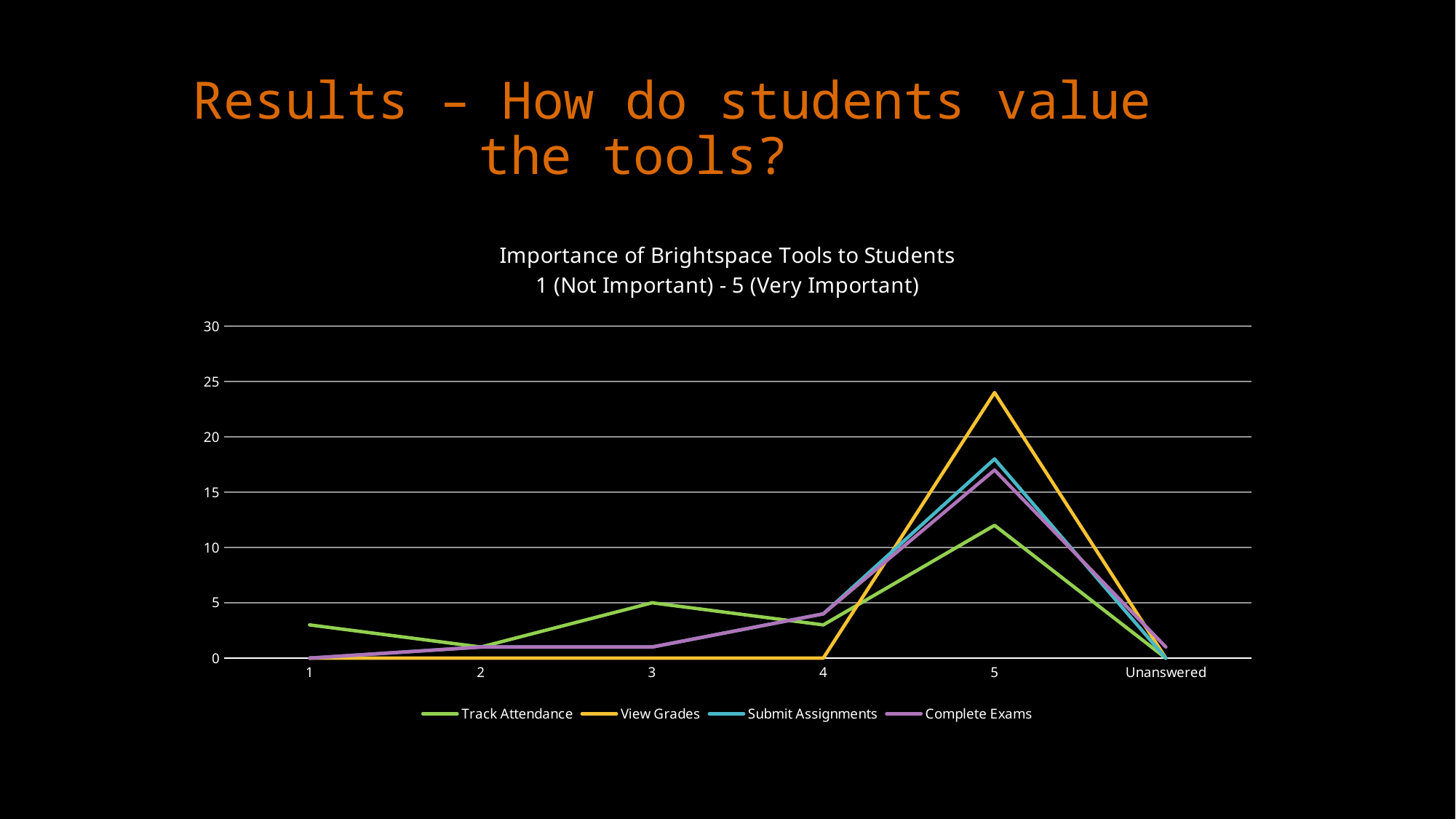
At rating 5, which is larger: View Grades or Track Attendance? View Grades How many series does the legend list? 4 What is the value for Track Attendance at rating 3? 5 What is the title of the chart? Importance of Brightspace Tools to Students 1 (Not Important) - 5 (Very Important) Is the value for Track Attendance at rating 5 greater or less than 10? greater Is the value for View Grades at rating 5 greater or less than 20? greater Which series has the highest value at rating 5? View Grades Is the value for Submit Assignments at rating 5 greater or less than 15? greater What is the value for View Grades at rating 2? 0 Does the View Grades line rise or fall from rating 5 to Unanswered? Fall How many categories are shown along the x axis? 6 What kind of chart is shown on the slide? Line chart